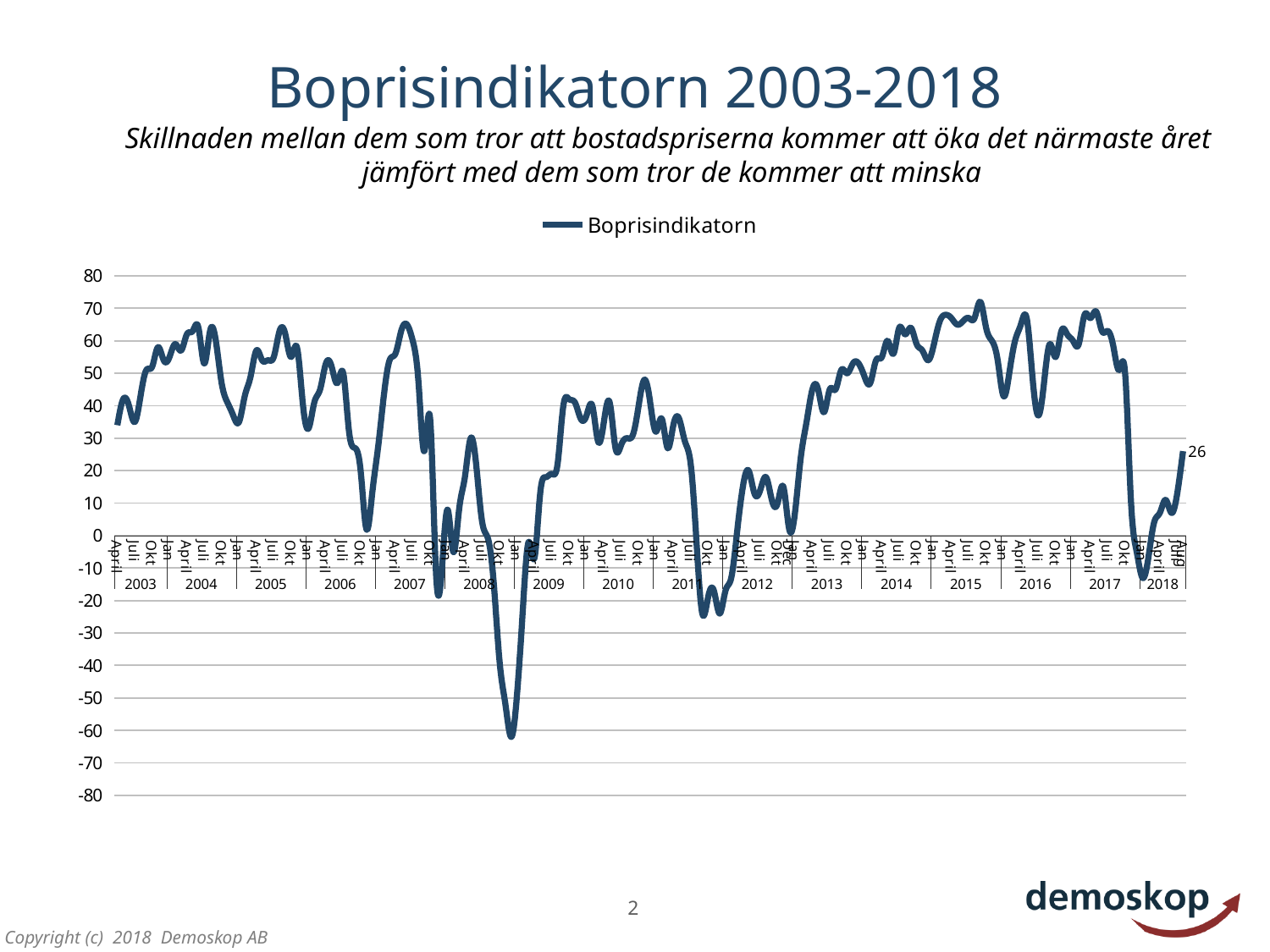
Is the value of Boprisindikatorn at the first point (April 2003) greater or less than 20? greater How many series does the legend list? 1 Is the lowest value of Boprisindikatorn on the chart greater or less than -50? less Which is lower: the trough of Boprisindikatorn in early 2009 or the trough in late 2011? early 2009 Is the highest value of Boprisindikatorn on the chart greater or less than 60? greater What is the name of the series shown in the legend? Boprisindikatorn What kind of chart is shown on the slide? line chart What is the title of the chart? Boprisindikatorn 2003-2018 Between the start of 2018 and Aug 2018, does the Boprisindikatorn line rise or fall? rise Between Okt 2017 and Jan 2018, does the Boprisindikatorn line rise or fall? fall How many years are labelled along the x axis? 16 What is the value of Boprisindikatorn at the last point on the chart (Aug 2018)? 26